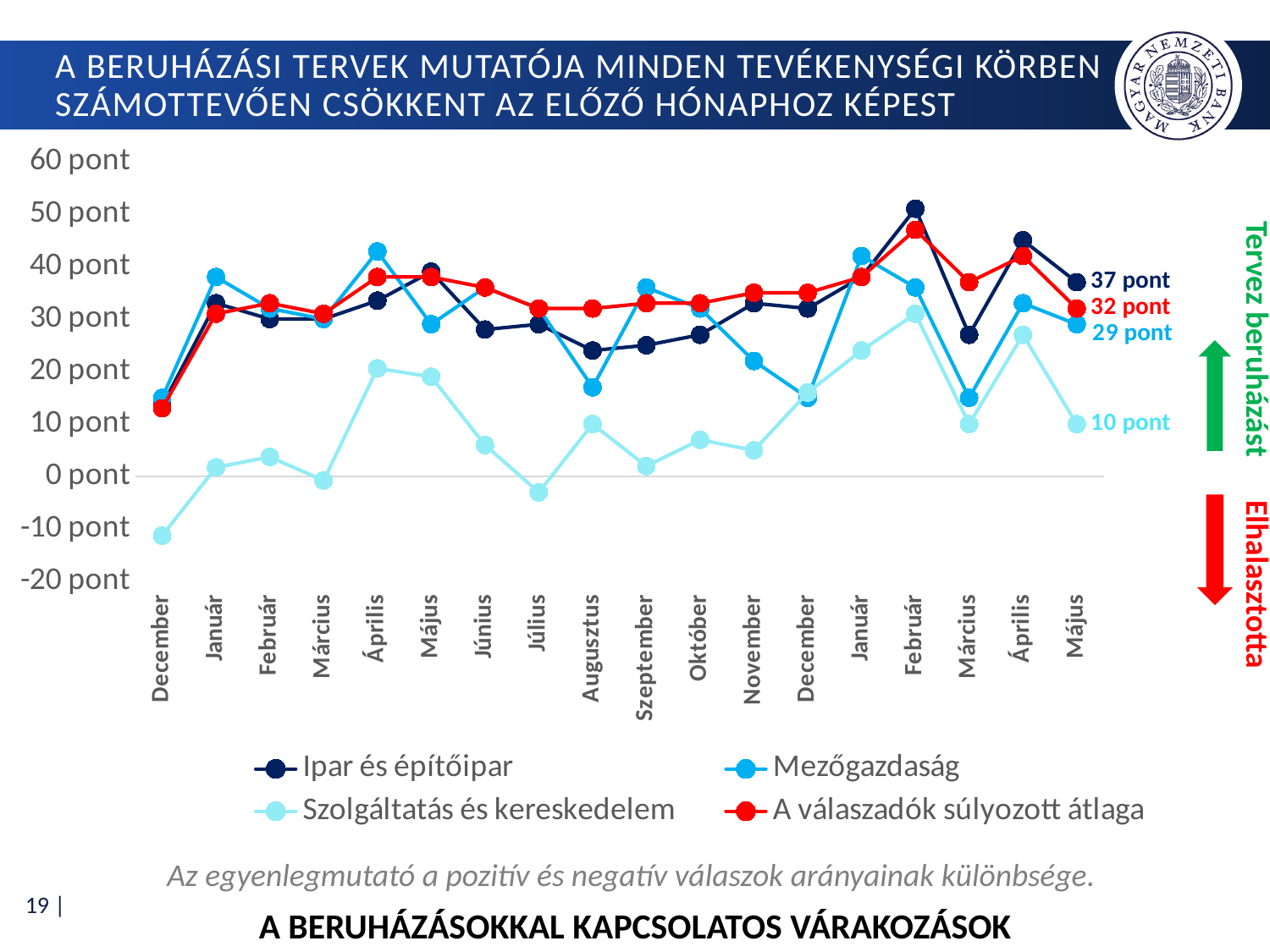
Is the value for Szolgáltatás és kereskedelem at the first December greater or less than 0 pont? less Which series has the highest value at the last point (Május)? Ipar és építőipar How many series does the legend list? 4 Is the value for Ipar és építőipar at the second Február greater or less than 40 pont? greater What kind of chart is shown on the slide? Line chart Which series has the lowest value at the last point (Május)? Szolgáltatás és kereskedelem What is the difference between the Ipar és építőipar and Mezőgazdaság values at the last point (Május)? 8 pont What is the value of the Mezőgazdaság series at the last point (Május)? 29 pont At the last point (Május), which is larger: the Ipar és építőipar value or the Szolgáltatás és kereskedelem value? Ipar és építőipar What is the value of the Ipar és építőipar series at the last point (Május) on the chart? 37 pont What is the value of the Szolgáltatás és kereskedelem series at the last point (Május)? 10 pont What is the value of A válaszadók súlyozott átlaga at the last point (Május)? 32 pont